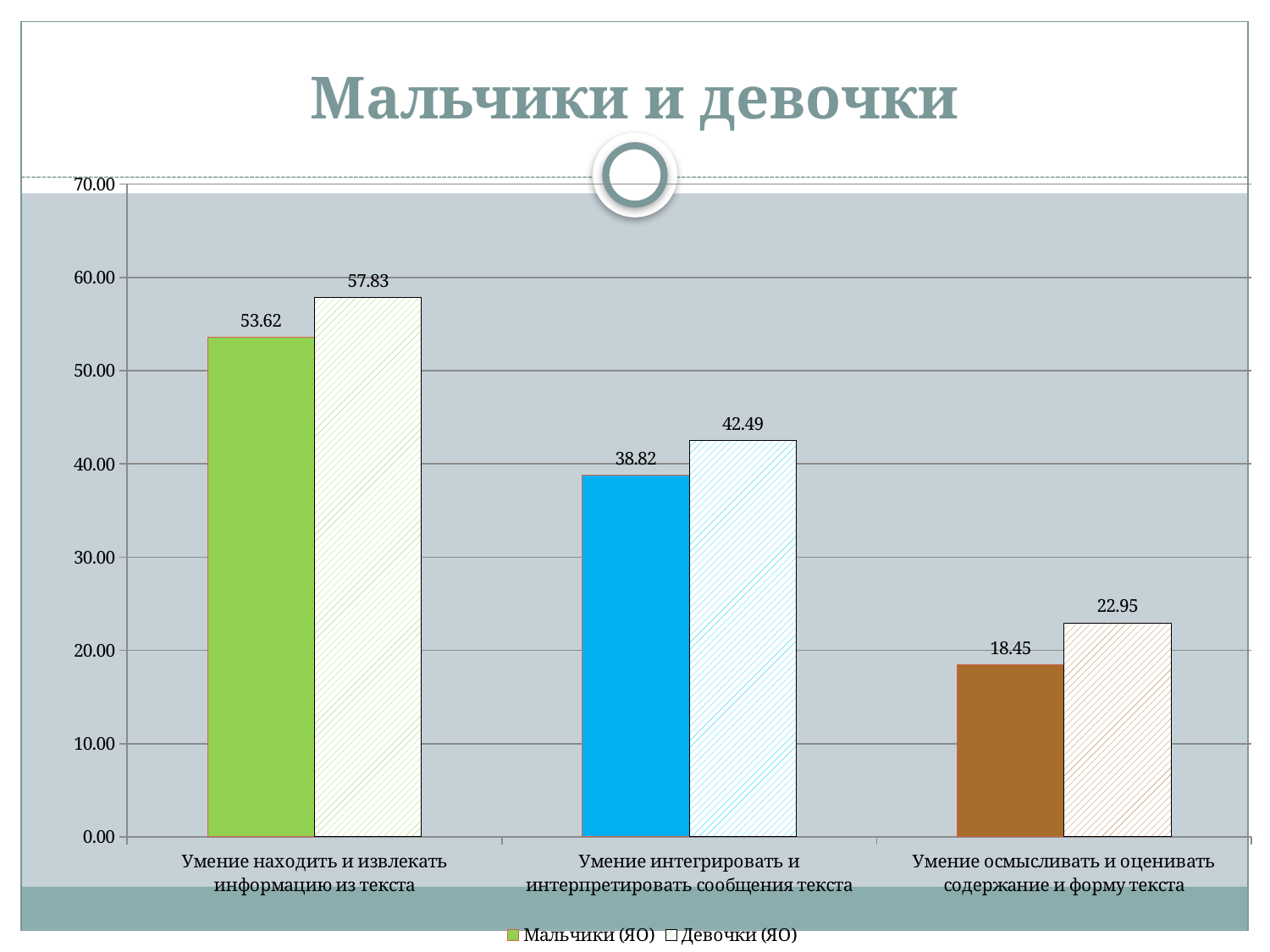
How many series does the legend list? 2 What is the value for Мальчики (ЯО) in the category 'Умение находить и извлекать информацию из текста'? 53.62 What is the difference between Девочки (ЯО) and Мальчики (ЯО) in the category 'Умение находить и извлекать информацию из текста'? 4.21 In the category 'Умение интегрировать и интерпретировать сообщения текста', which series has the larger value, Мальчики (ЯО) or Девочки (ЯО)? Девочки (ЯО) Which category has the highest value for Девочки (ЯО)? Умение находить и извлекать информацию из текста What is the value for Девочки (ЯО) in the category 'Умение осмысливать и оценивать содержание и форму текста'? 22.95 Is the value for Мальчики (ЯО) in 'Умение интегрировать и интерпретировать сообщения текста' greater or less than 40.00? less What is the value for Девочки (ЯО) in the category 'Умение интегрировать и интерпретировать сообщения текста'? 42.49 How many categories are shown on the x axis? 3 Which category has the lowest value for Мальчики (ЯО)? Умение осмысливать и оценивать содержание и форму текста What is the value for Мальчики (ЯО) in the category 'Умение осмысливать и оценивать содержание и форму текста'? 18.45 What kind of chart is shown on the slide? bar chart